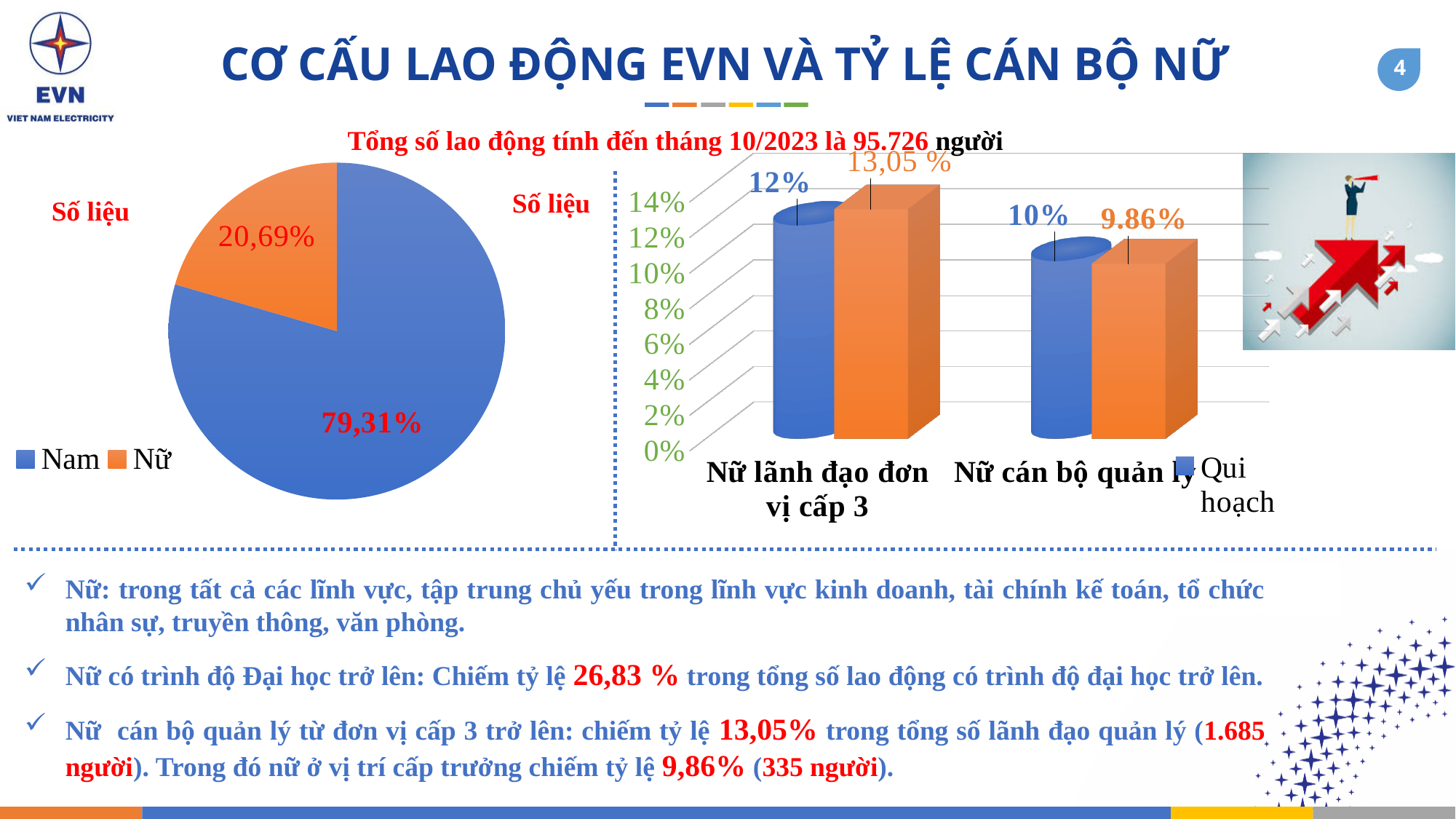
On the pie chart on the left, how many slices are there? 2 On the pie chart on the left, what percentage is shown for Nam? 79,31% On the bar chart on the right, what is the value of the orange bar for Nữ lãnh đạo đơn vị cấp 3? 13,05 % On the pie chart on the left, which slice is larger, Nam or Nữ? Nam On the bar chart on the right, which bar is taller for Nữ cán bộ quản lý, the blue (Qui hoạch) bar or the orange bar? the blue (Qui hoạch) bar On the bar chart on the right, what is the value of the orange bar for Nữ cán bộ quản lý? 9.86% On the pie chart on the left, what is the difference in percentage points between the Nam and Nữ slices? 58,62 On the bar chart on the right, how many categories are shown on the x axis? 2 What kind of chart is the chart on the right of the slide? bar chart On the pie chart on the left, what percentage is shown for Nữ? 20,69% On the bar chart on the right, what is the value of the blue (Qui hoạch) bar for Nữ lãnh đạo đơn vị cấp 3? 12% What kind of chart is the chart on the left of the slide? pie chart